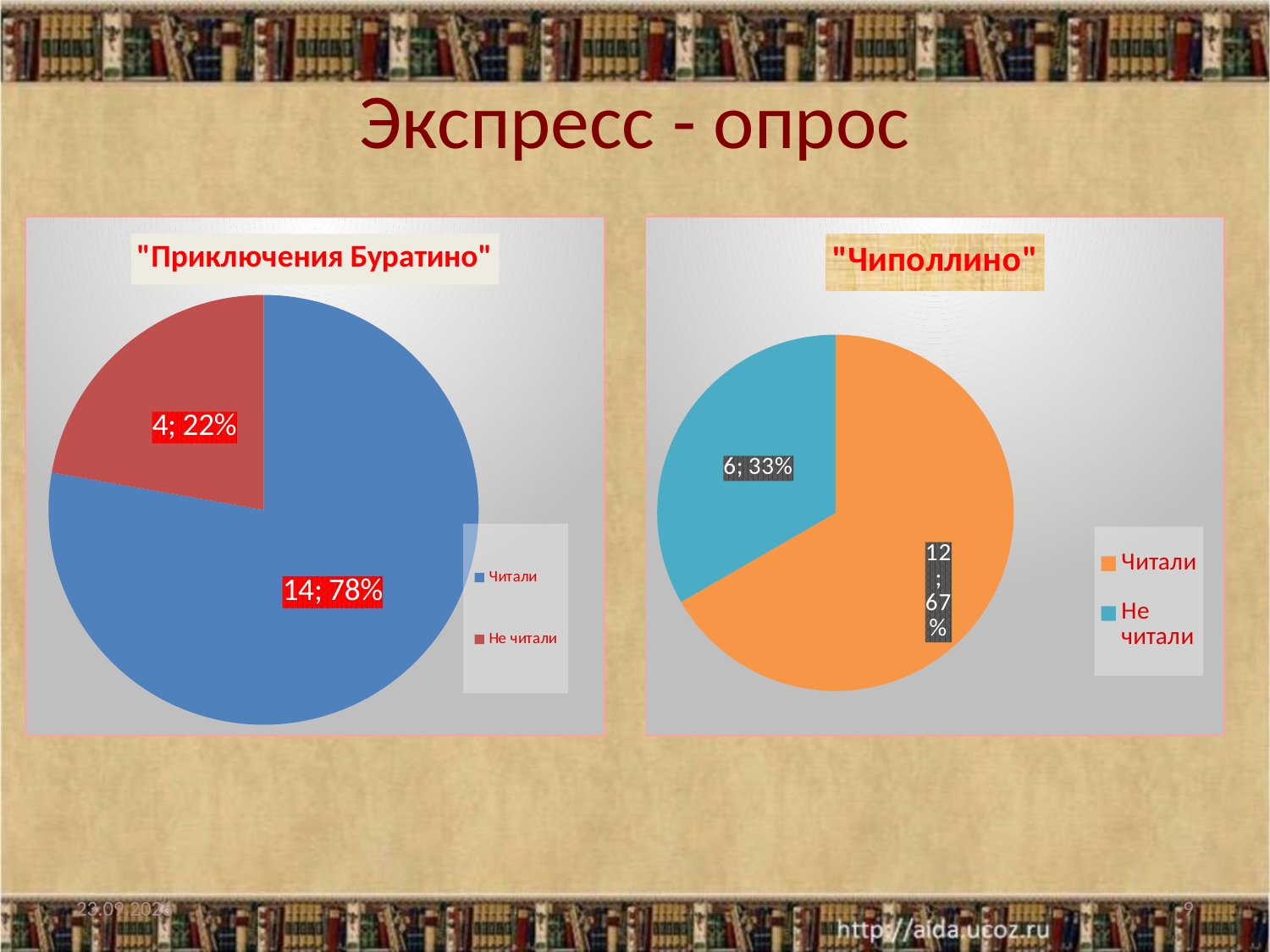
In the "Чиполлино" chart, what percentage share does the "Читали" slice have? 67% In the "Чиполлино" chart, what colour is the "Читали" slice? Orange In the "Чиполлино" chart, what is the difference between the number who read (Читали) and the number who did not (Не читали)? 6 In the "Чиполлино" chart, which slice is the smallest? Не читали In the "Приключения Буратино" chart, which slice is the largest? Читали What type of chart is the "Чиполлино" chart? Pie chart How many series does the legend of the "Приключения Буратино" chart list? 2 In the "Приключения Буратино" chart, how many respondents are in the "Читали" slice? 14 In the "Приключения Буратино" chart, what percentage share does the "Не читали" slice have? 22% In the "Приключения Буратино" chart, what is the difference between the number who read (Читали) and the number who did not (Не читали)? 10 In the "Чиполлино" chart, how many respondents are in the "Не читали" slice? 6 Which chart has the larger "Не читали" count, "Приключения Буратино" or "Чиполлино"? Чиполлино